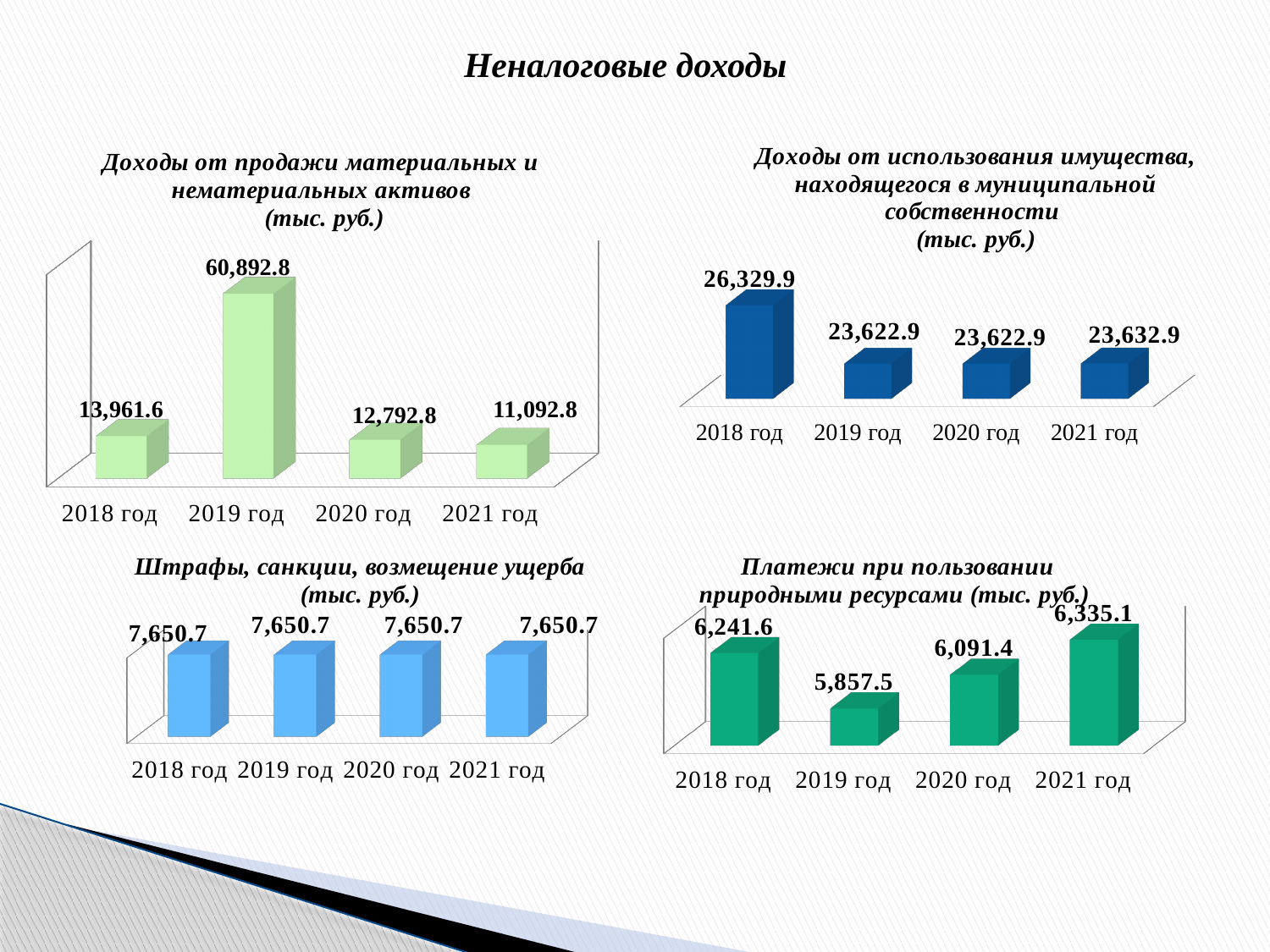
In the top-left chart (Доходы от продажи материальных и нематериальных активов), what is the value for 2019 год? 60,892.8 In the top-left chart (Доходы от продажи материальных и нематериальных активов), which year has the lowest value? 2021 год In the top-right chart (Доходы от использования имущества), what is the difference between the 2018 год and 2019 год values? 2,707.0 In the bottom-left chart (Штрафы, санкции, возмещение ущерба), what is the value for 2020 год? 7,650.7 In the top-right chart (Доходы от использования имущества), what is the value for 2018 год? 26,329.9 In the top-right chart (Доходы от использования имущества), which year has the highest value? 2018 год How many charts are shown on the slide, and what type are they? 4 bar charts In the bottom-left chart (Штрафы, санкции, возмещение ущерба), do the values rise, fall, or stay the same from 2018 год to 2021 год? stay the same In the bottom-right chart (Платежи при пользовании природными ресурсами), what is the value for 2019 год? 5,857.5 In the bottom-right chart (Платежи при пользовании природными ресурсами), which is larger, the value for 2018 год or 2020 год? 2018 год In the top-left chart (Доходы от продажи материальных и нематериальных активов), what is the difference between the 2018 год and 2020 год values? 1,168.8 In the bottom-right chart (Платежи при пользовании природными ресурсами), which year has the highest value? 2021 год